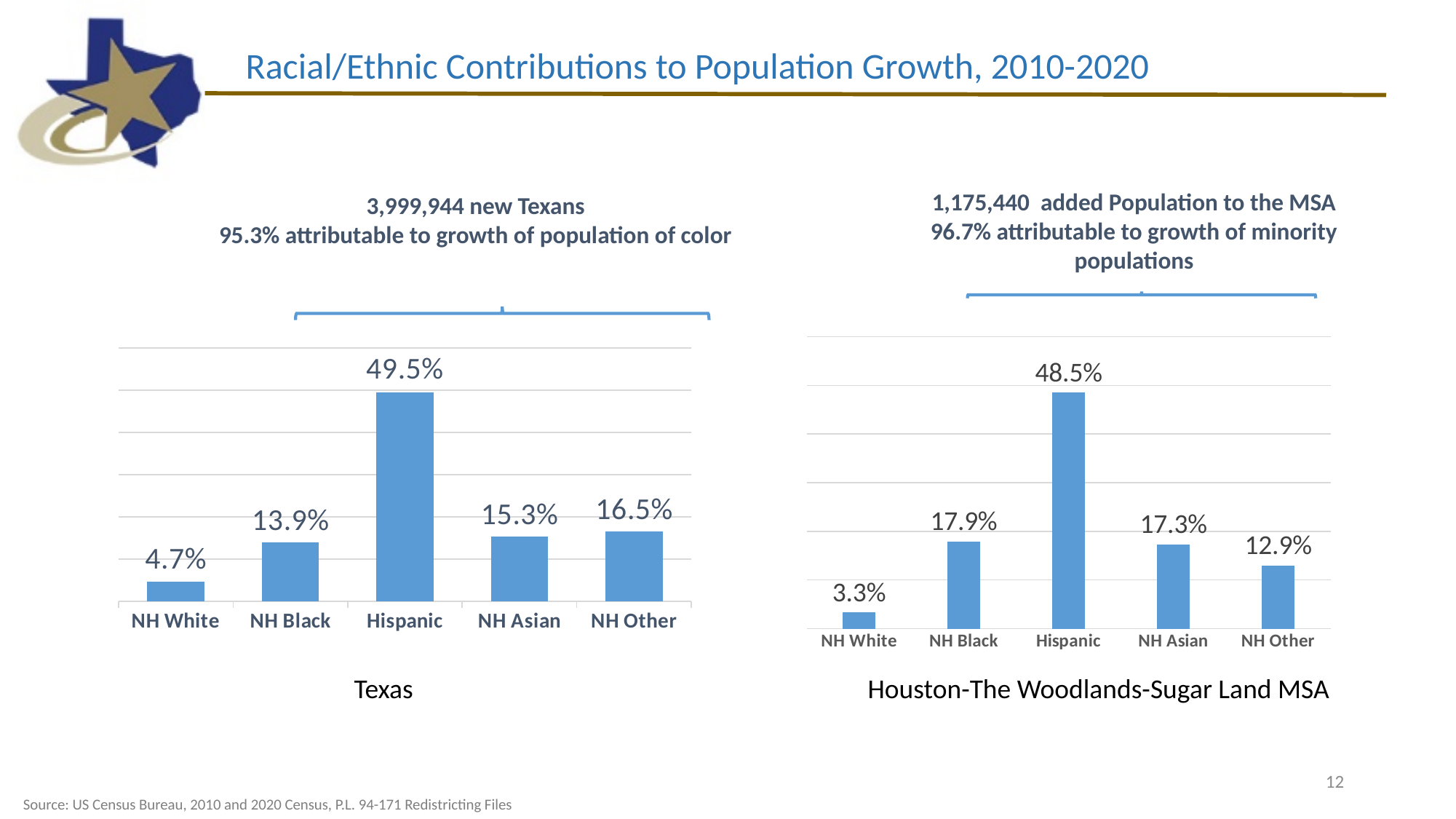
According to the text above the Texas chart, how many new Texans were added? 3,999,944 What kind of chart is the Houston-The Woodlands-Sugar Land MSA chart? Bar chart In the Texas chart, what is the difference between the Hispanic and NH White values? 44.8% How many categories are shown in the Texas chart? 5 In the Houston-The Woodlands-Sugar Land MSA chart, what is the difference between the NH Black and NH Other values? 5.0% In the Houston-The Woodlands-Sugar Land MSA chart, which is larger, NH Asian or NH Other? NH Asian In the Houston-The Woodlands-Sugar Land MSA chart, what is the value for NH White? 3.3% In the Texas chart, which category has the lowest value? NH White In the Texas chart, what is the value for Hispanic? 49.5% In the Texas chart, what is the value for NH Asian? 15.3% In the Houston-The Woodlands-Sugar Land MSA chart, which category has the highest value? Hispanic In the Texas chart, which is larger, NH Black or NH Other? NH Other